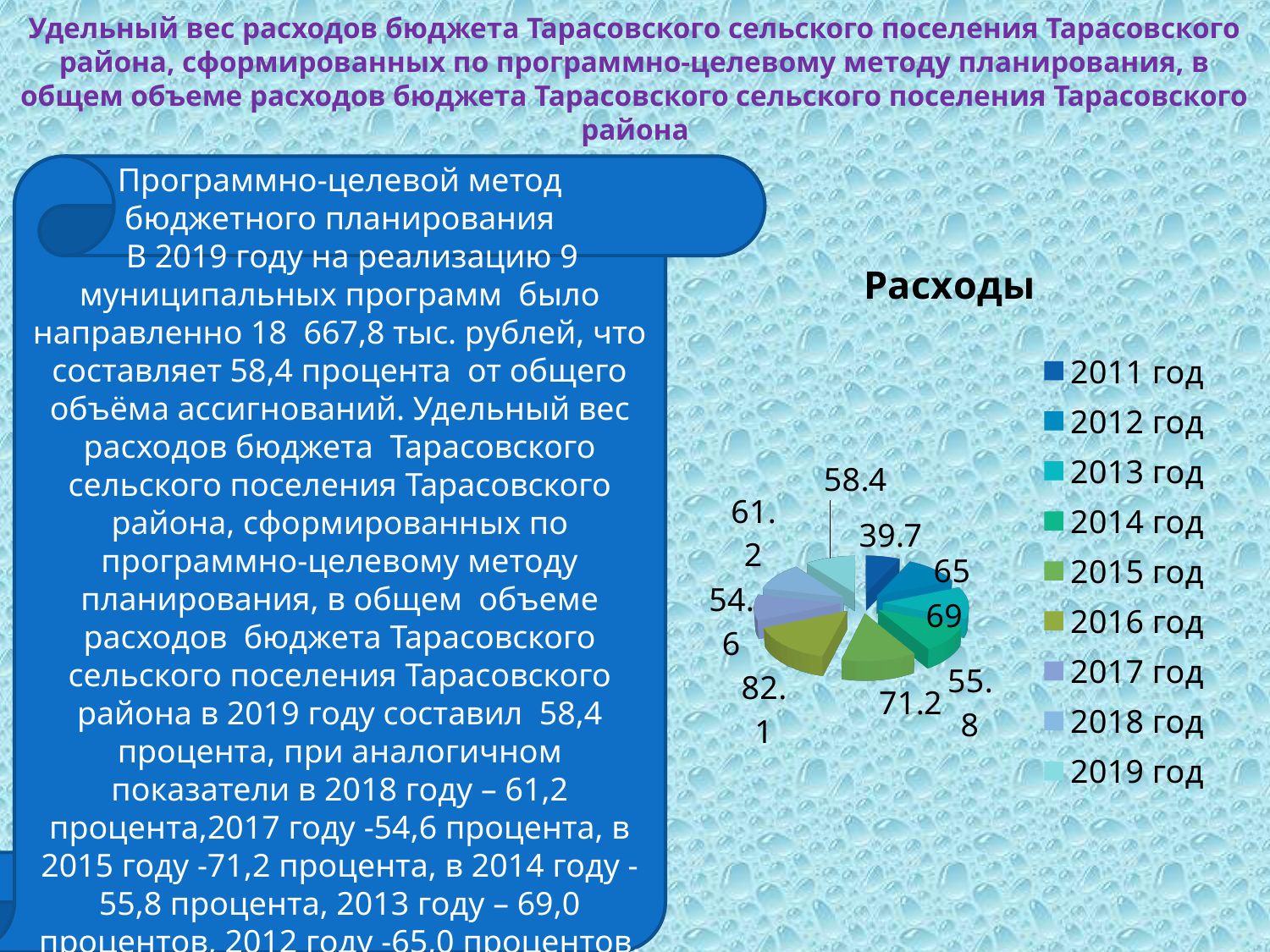
What is the difference between the labelled values for 2016 год and 2011 год? 42.4 Which has the larger labelled value, 2015 год or 2014 год? 2015 год What value is labelled on the slice for 2016 год? 82.1 How many entries does the chart legend list? 9 How many slices does the pie chart have? 9 What value is labelled on the slice for 2011 год? 39.7 What is the title of the chart? Расходы What type of chart is shown on the slide? pie chart What value is labelled on the slice for 2015 год? 71.2 Which year has the smallest labelled value in the pie chart? 2011 год Which year has the largest labelled value in the pie chart? 2016 год What value is labelled on the slice for 2019 год? 58.4